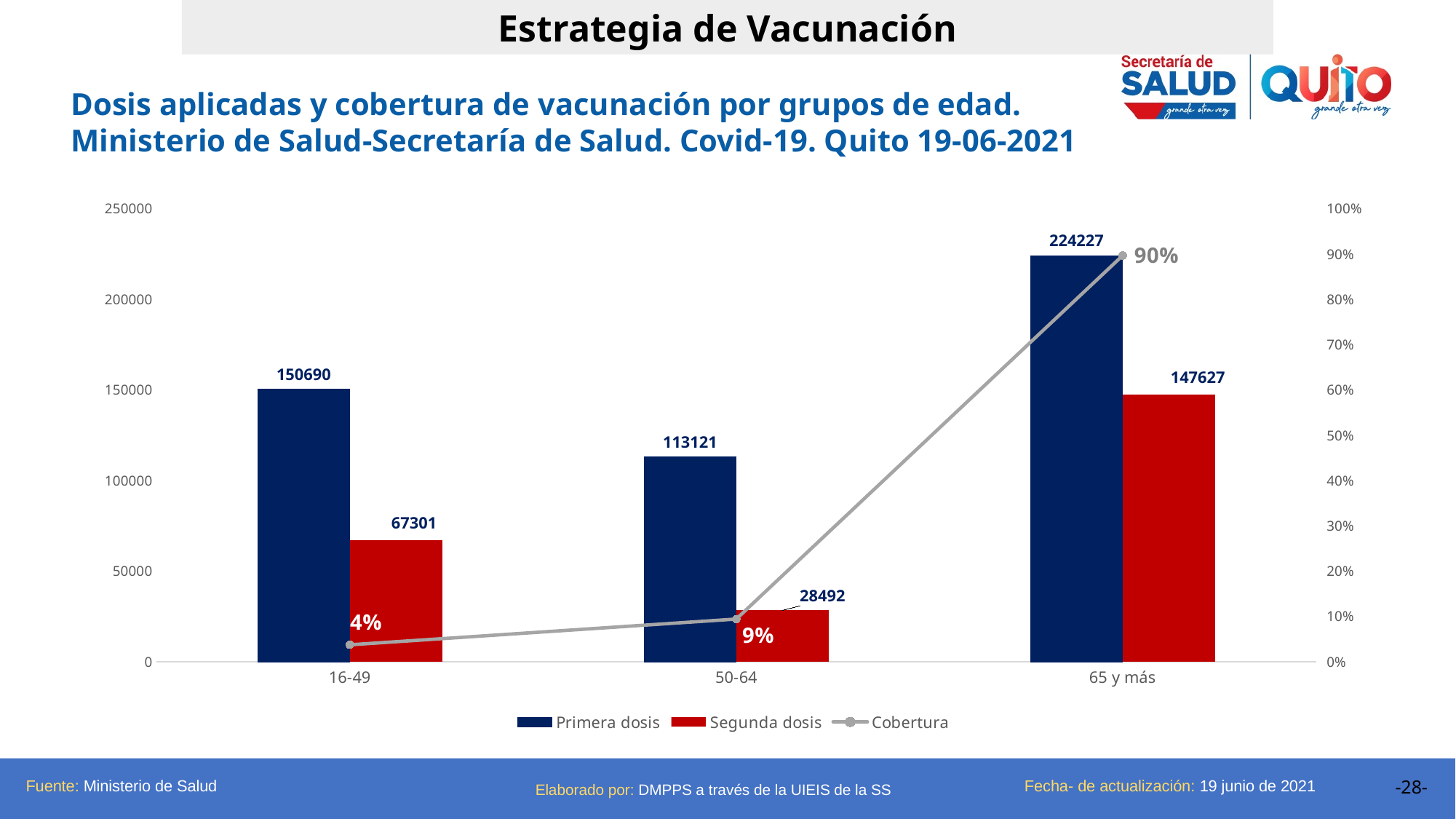
Which age group has the lowest Segunda dosis value? 50-64 Which is larger: Primera dosis for 16-49 or Primera dosis for 50-64? Primera dosis for 16-49 What is the difference between Primera dosis and Segunda dosis for the 65 y más age group? 76600 Is the Segunda dosis value for 16-49 greater or less than 50000? greater How many age groups are shown on the x axis? 3 How many series does the legend list? 3 What kind of chart is used to show Primera dosis and Segunda dosis? Bar chart Does the Cobertura line rise or fall from 16-49 to 65 y más? Rises What is the value of Primera dosis for the 16-49 age group? 150690 What is the value of Segunda dosis for the 50-64 age group? 28492 What is the Cobertura percentage for the 65 y más age group? 90% Which age group has the highest Primera dosis value? 65 y más